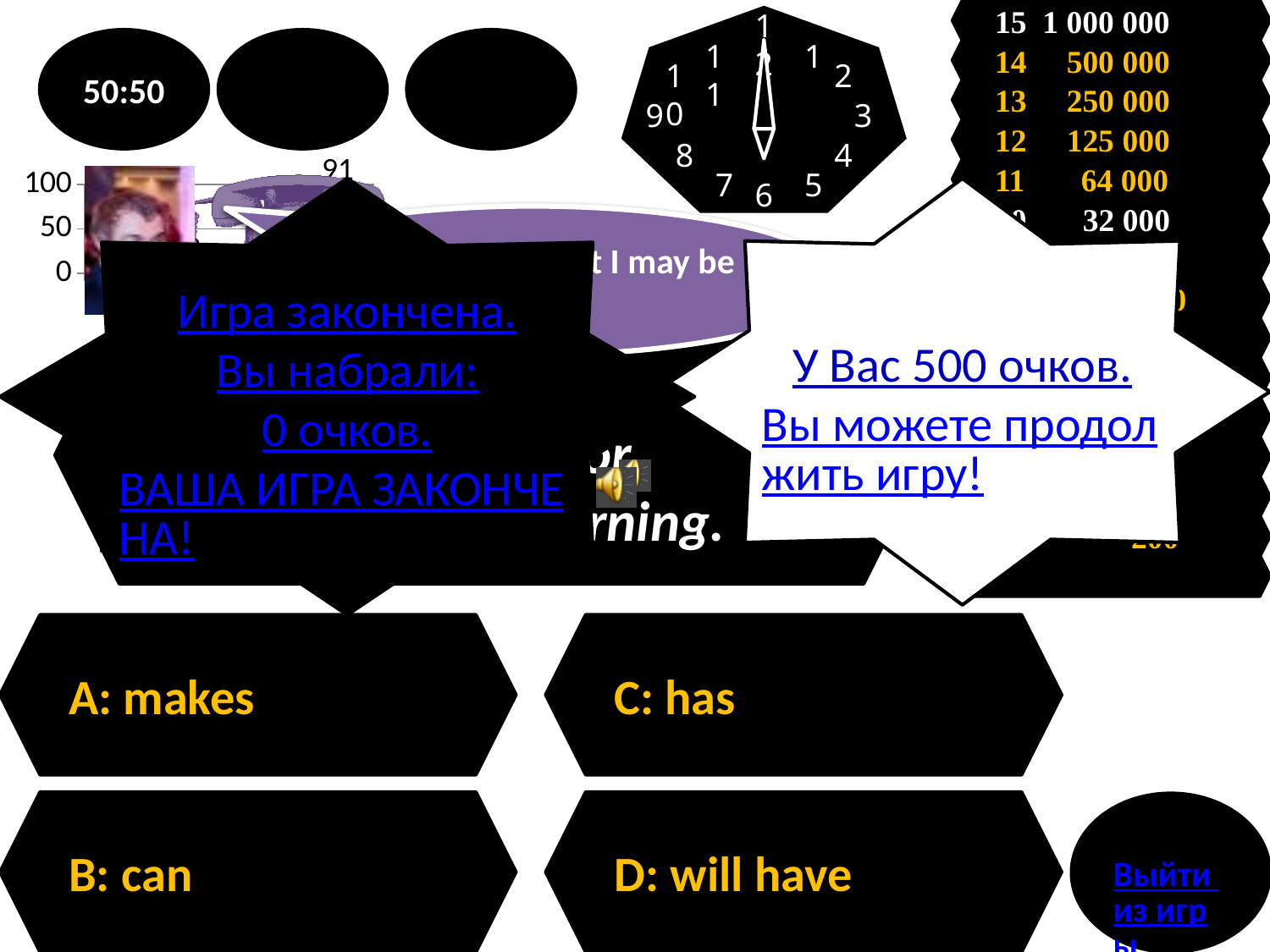
What is the highest tick value shown on the vertical axis of the small chart in the upper left? 100 What value is printed as a data label on the small chart in the upper left of the slide? 91 What tick values are shown on the vertical axis of the small chart in the upper left? 0, 50, 100 On the small chart in the upper left, is the labelled value 91 greater or less than 50? greater On the small chart in the upper left, is the labelled value greater or less than 100? less